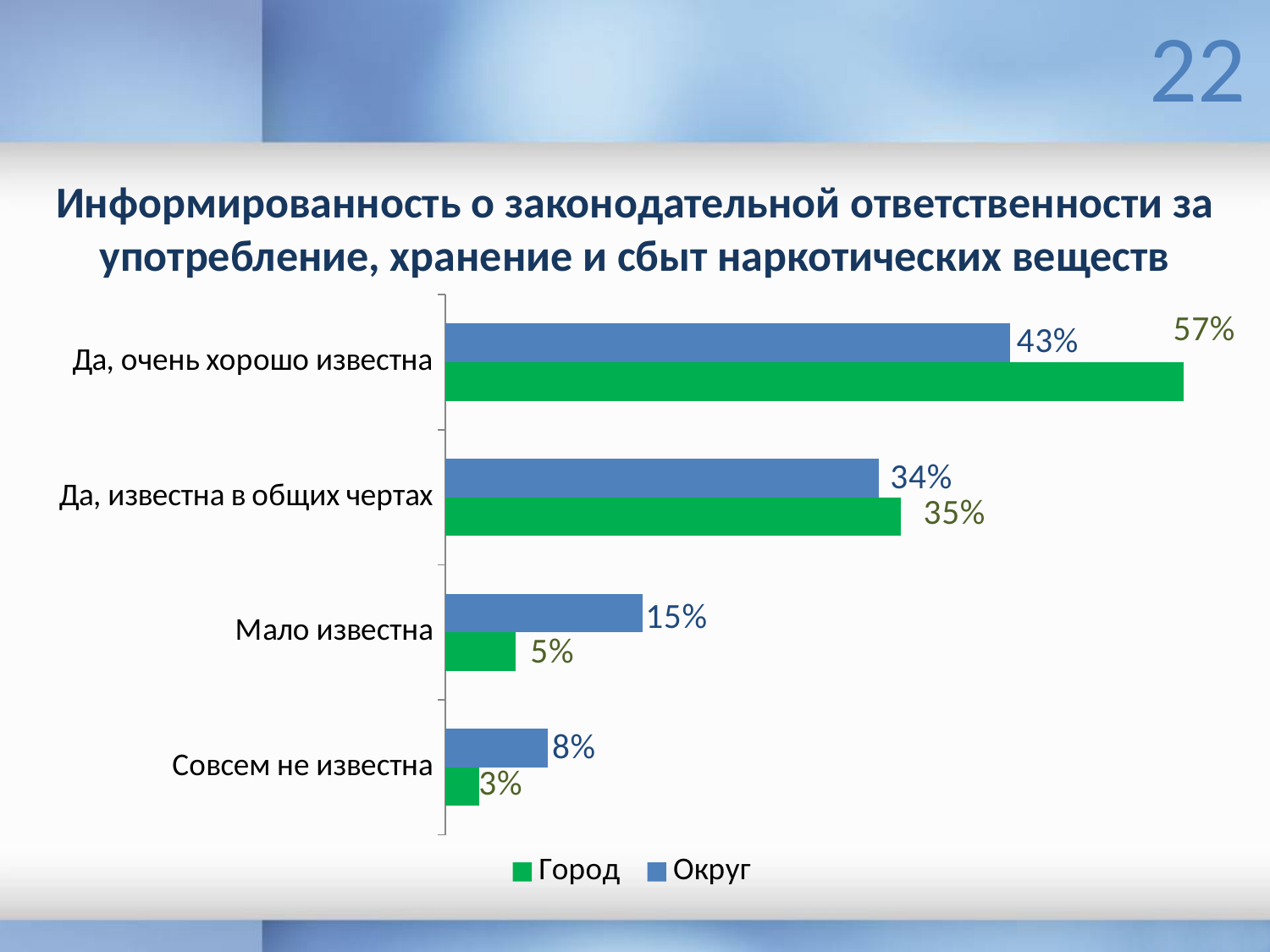
What is the value for Город in the category "Да, очень хорошо известна"? 57% What is the value for Округ in the category "Мало известна"? 15% What is the difference between the Город and Округ values in the category "Да, очень хорошо известна"? 14% How many series does the legend list? 2 How many categories are shown on the chart? 4 What kind of chart is shown on the slide? Bar chart In the category "Мало известна", which series has the larger value, Город or Округ? Округ What is the value for Город in the category "Совсем не известна"? 3% Which colour represents the series Город in the chart? Green Which category has the lowest value for Округ? Совсем не известна What is the value for Округ in the category "Да, известна в общих чертах"? 34% Which category has the highest value for Город? Да, очень хорошо известна